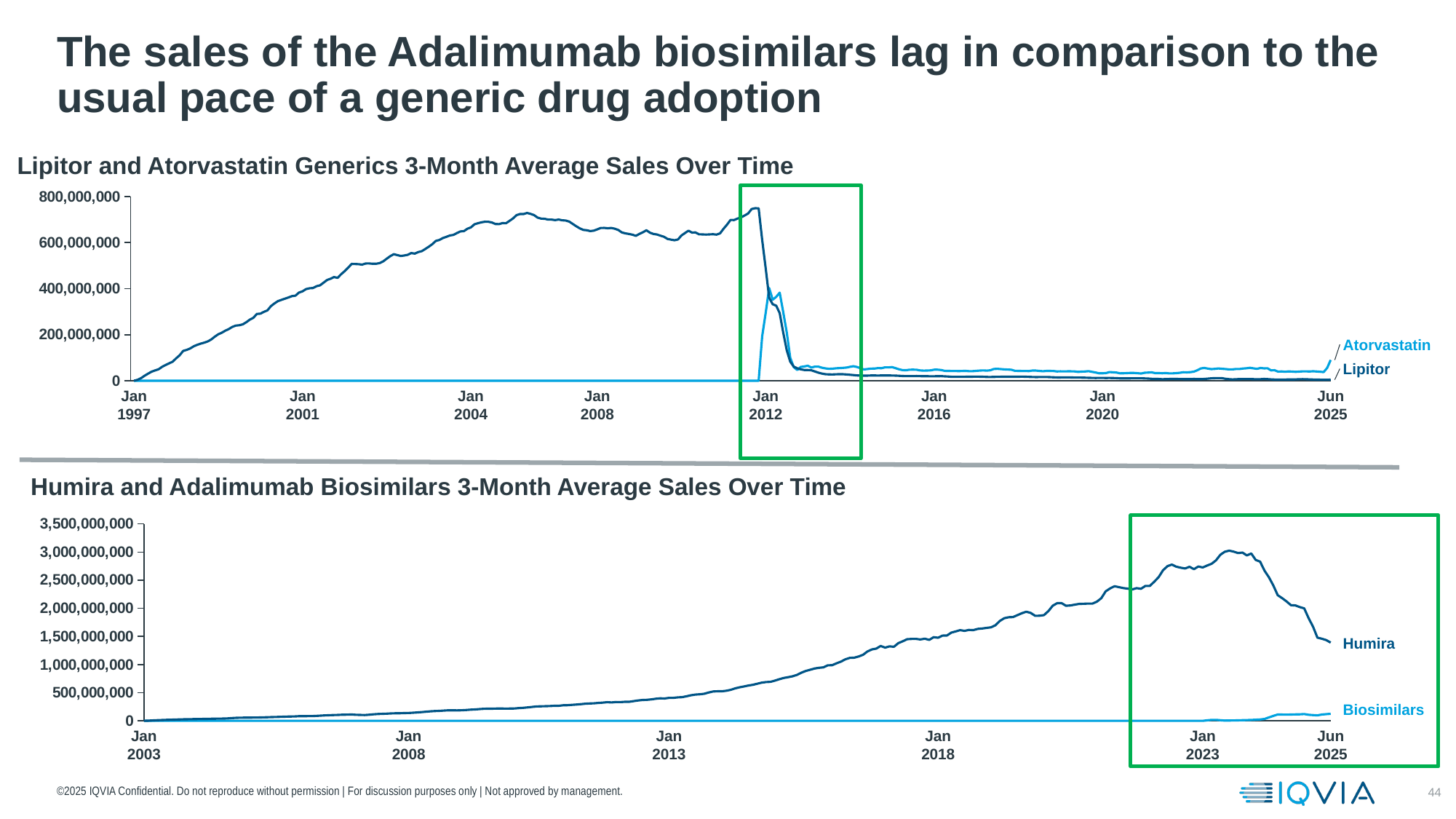
In the top chart, is the Atorvastatin value at Jan 2004 greater or less than 200,000,000? less In the bottom chart, does the Humira line rise or fall between Jan 2003 and Jan 2018? Rise How many series are labelled on the bottom chart, 'Humira and Adalimumab Biosimilars 3-Month Average Sales Over Time'? 2 In the top chart, is the Lipitor value at Jan 2020 greater or less than 200,000,000? less What kind of chart is the top chart, 'Lipitor and Atorvastatin Generics 3-Month Average Sales Over Time'? Line chart In the bottom chart, which series has the larger value at Jun 2025, Humira or Biosimilars? Humira In the bottom chart, is the Humira value at Jun 2025 greater or less than 2,000,000,000? less In the top chart, is the Lipitor value larger at Jan 2012 or at Jan 2016? Jan 2012 What is the highest value shown on the y axis of the bottom chart? 3,500,000,000